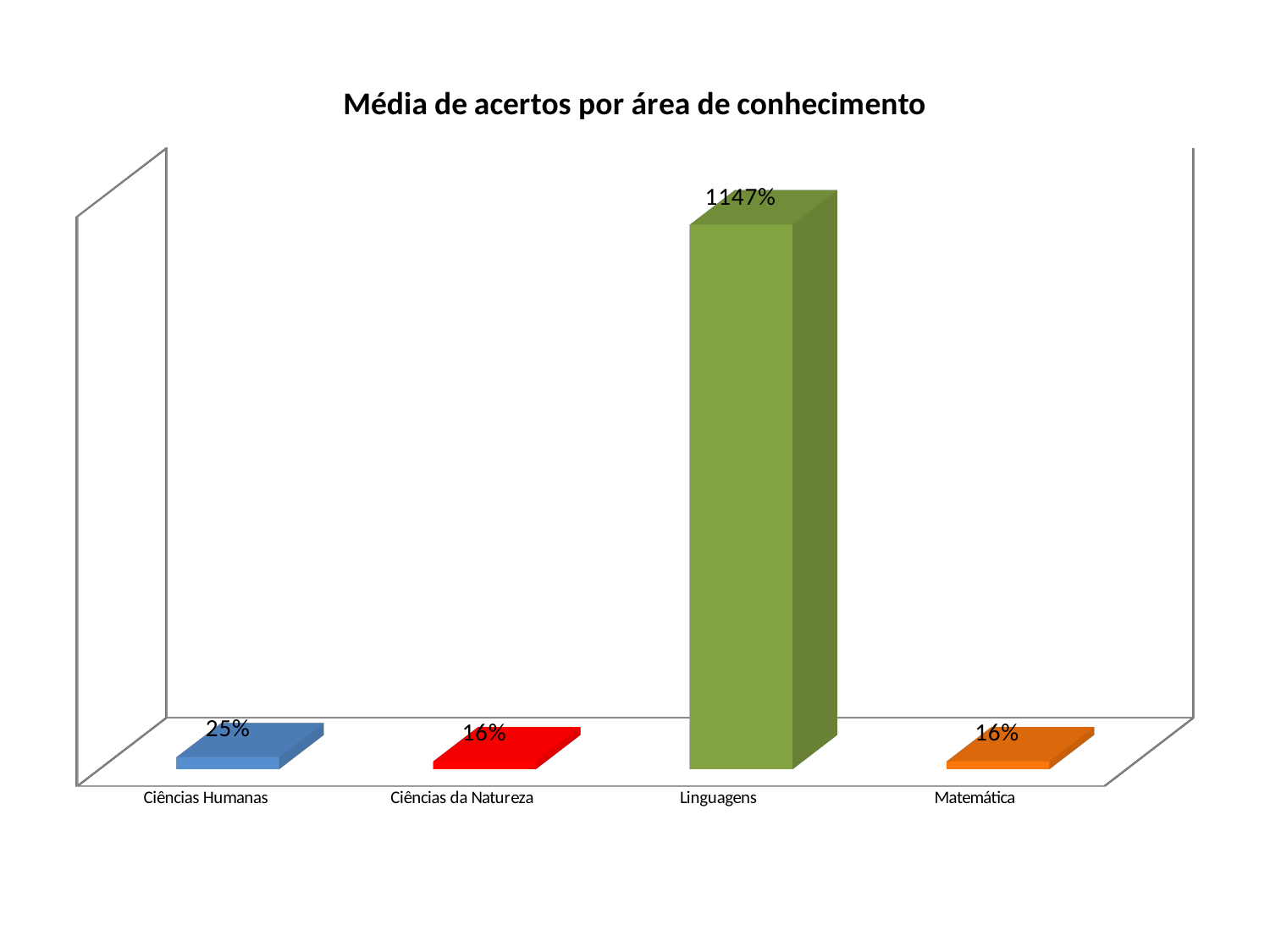
What is the value for Linguagens? 1147% How many categories are shown on the x axis? 4 What is the value for Matemática? 16% What kind of chart is shown on the slide? Bar chart What is the difference between the values for Ciências Humanas and Matemática? 9% Which is larger, the value for Ciências Humanas or the value for Ciências da Natureza? Ciências Humanas What is the title of the chart? Média de acertos por área de conhecimento Which category has the highest value? Linguagens What is the value for Ciências da Natureza? 16% What colour is the bar for Linguagens? Green What is the value for Ciências Humanas? 25% What is the difference between the values for Linguagens and Ciências Humanas? 1122%